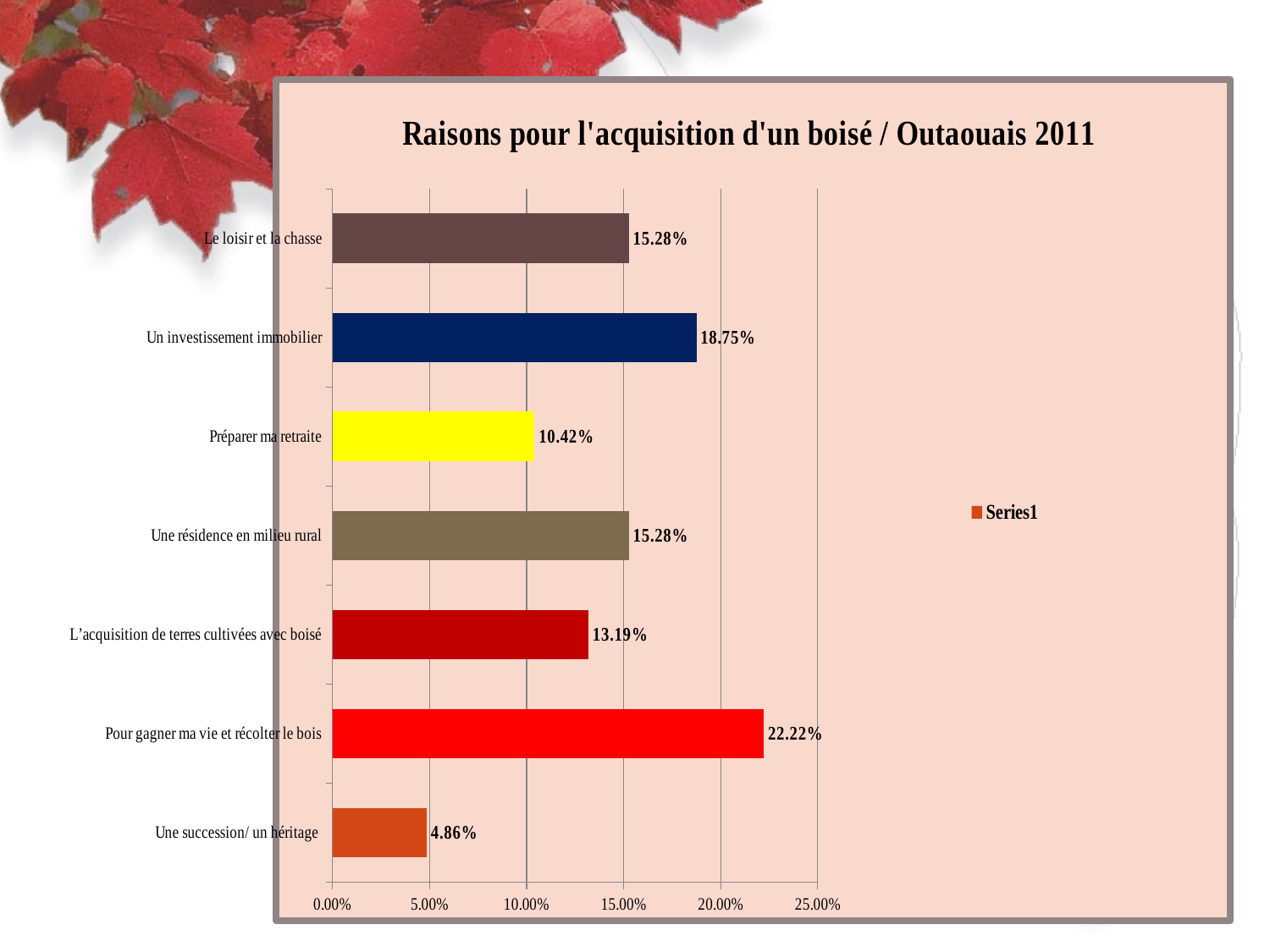
What is the value for "Un investissement immobilier"? 18.75% Which category has the lowest value? Une succession/ un héritage What kind of chart is shown on the slide? Bar chart What is the title of the chart? Raisons pour l'acquisition d'un boisé / Outaouais 2011 What is the value for "Préparer ma retraite"? 10.42% Which category has the highest value? Pour gagner ma vie et récolter le bois What is the value for "Pour gagner ma vie et récolter le bois"? 22.22% What is the difference between "Pour gagner ma vie et récolter le bois" and "Un investissement immobilier"? 3.47% How many categories are shown in the chart? 7 Is the value for "Un investissement immobilier" greater or less than 15.00%? greater Which is larger: "L’acquisition de terres cultivées avec boisé" or "Préparer ma retraite"? L’acquisition de terres cultivées avec boisé What is the value for "Une succession/ un héritage"? 4.86%